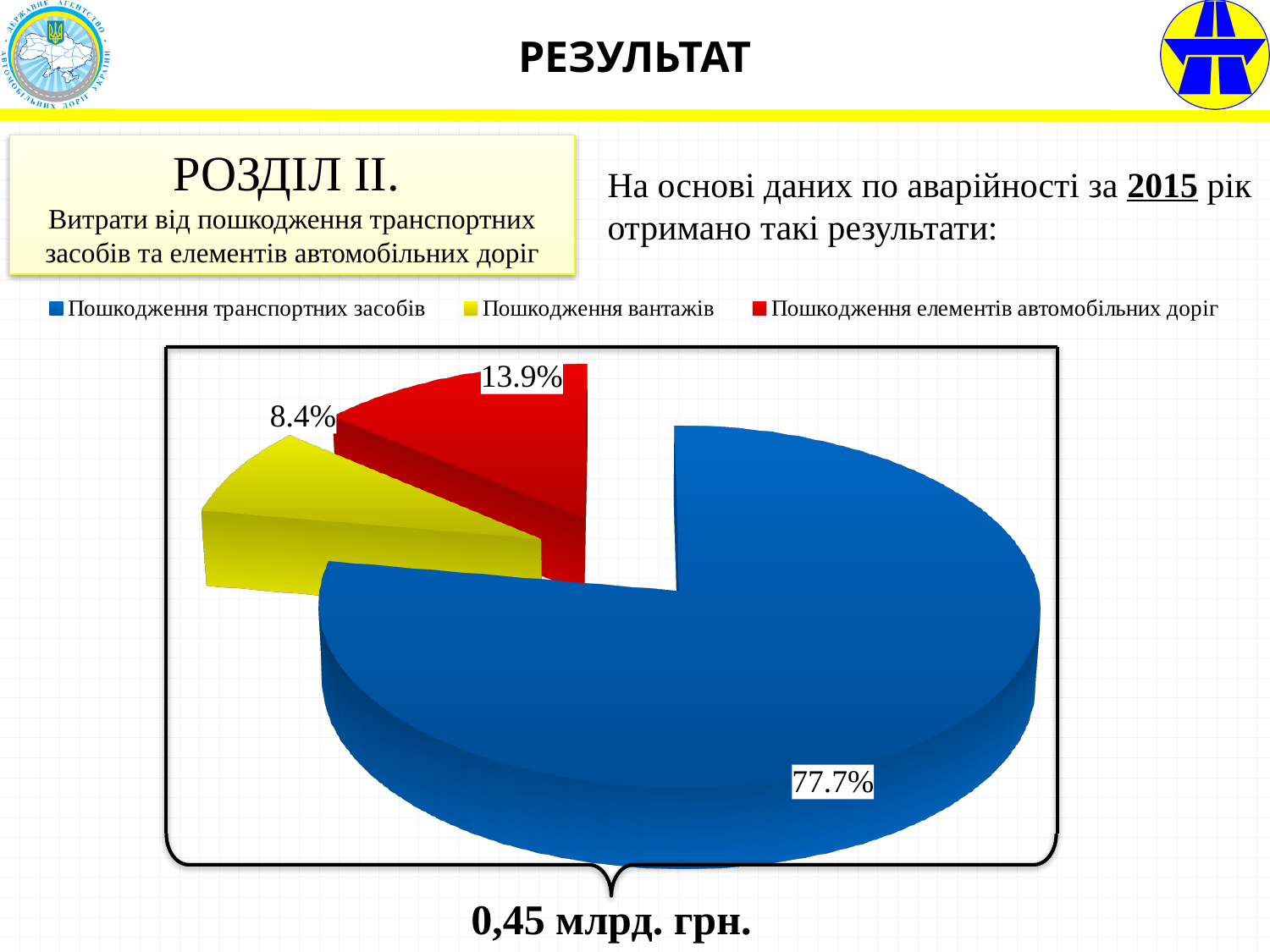
Which category has the largest slice of the pie? Пошкодження транспортних засобів What share of the pie does "Пошкодження транспортних засобів" have? 77.7% What kind of chart is shown on the slide? Pie chart What share of the pie does "Пошкодження вантажів" have? 8.4% Which is larger: the share for "Пошкодження елементів автомобільних доріг" or the share for "Пошкодження вантажів"? Пошкодження елементів автомобільних доріг What is the difference in percentage points between "Пошкодження елементів автомобільних доріг" and "Пошкодження вантажів"? 5.5 How many entries does the legend list? 3 What colour is the slice for "Пошкодження вантажів"? Yellow What share of the pie does "Пошкодження елементів автомобільних доріг" have? 13.9% What total amount is written below the pie chart? 0,45 млрд. грн. How many slices does the pie chart have? 3 Which category has the smallest slice of the pie? Пошкодження вантажів